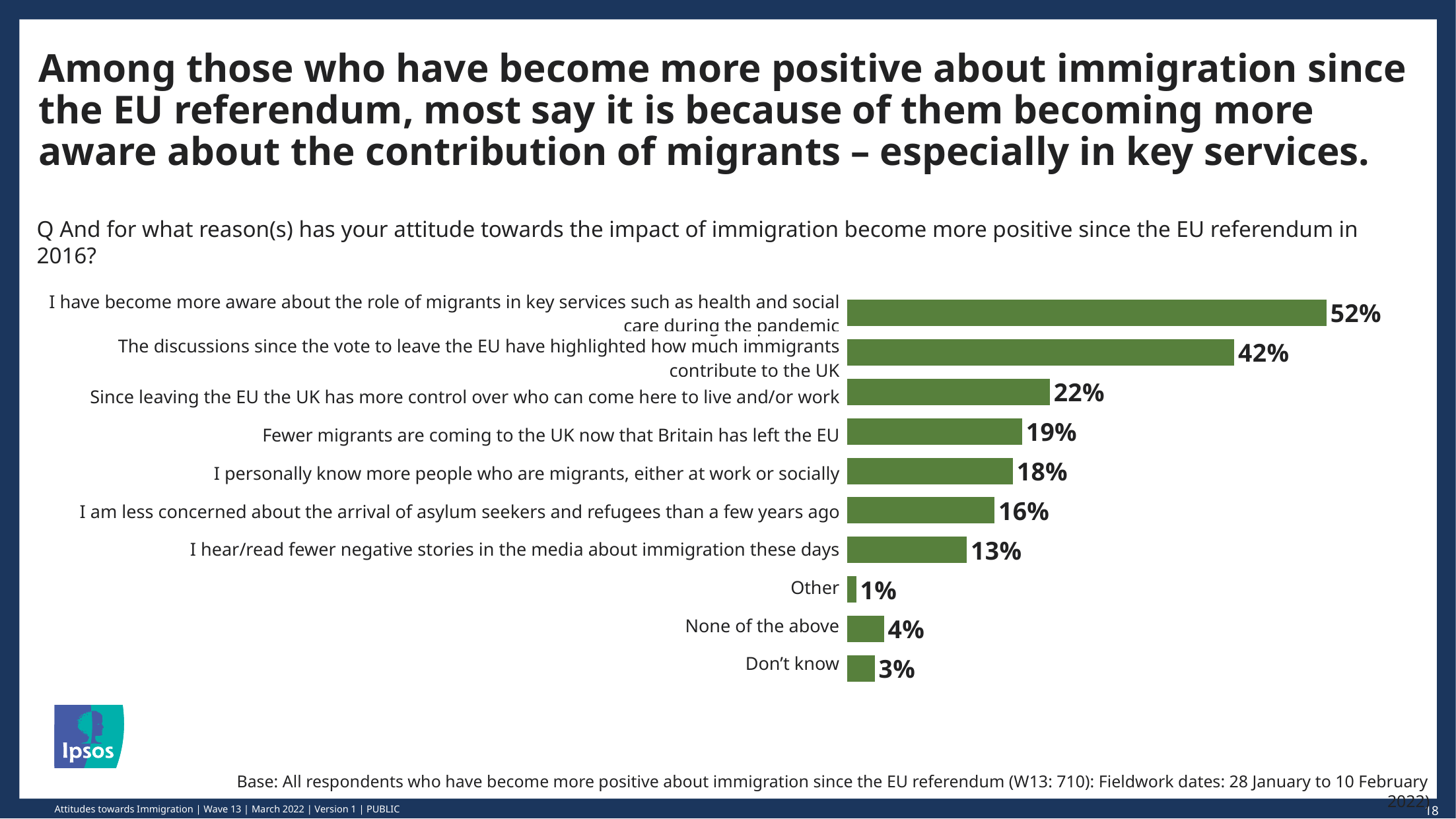
Which is larger: 'Fewer migrants are coming to the UK now that Britain has left the EU' or 'I am less concerned about the arrival of asylum seekers and refugees than a few years ago'? Fewer migrants are coming to the UK now that Britain has left the EU Which category has the lowest percentage? Other What colour are the bars in the chart? Green How many categories (bars) are shown in the chart? 10 Which reason has the highest percentage? I have become more aware about the role of migrants in key services such as health and social care during the pandemic What type of chart is shown on the slide? Bar chart What is the value for 'I hear/read fewer negative stories in the media about immigration these days'? 13% What percentage said the discussions since the vote to leave the EU have highlighted how much immigrants contribute to the UK? 42% What percentage of respondents said they have become more aware about the role of migrants in key services such as health and social care during the pandemic? 52% What is the difference between 'None of the above' and 'Don't know'? 1 percentage point What is the difference in percentage points between the top reason (52%) and the second reason (42%)? 10 percentage points What percentage answered 'Don't know'? 3%